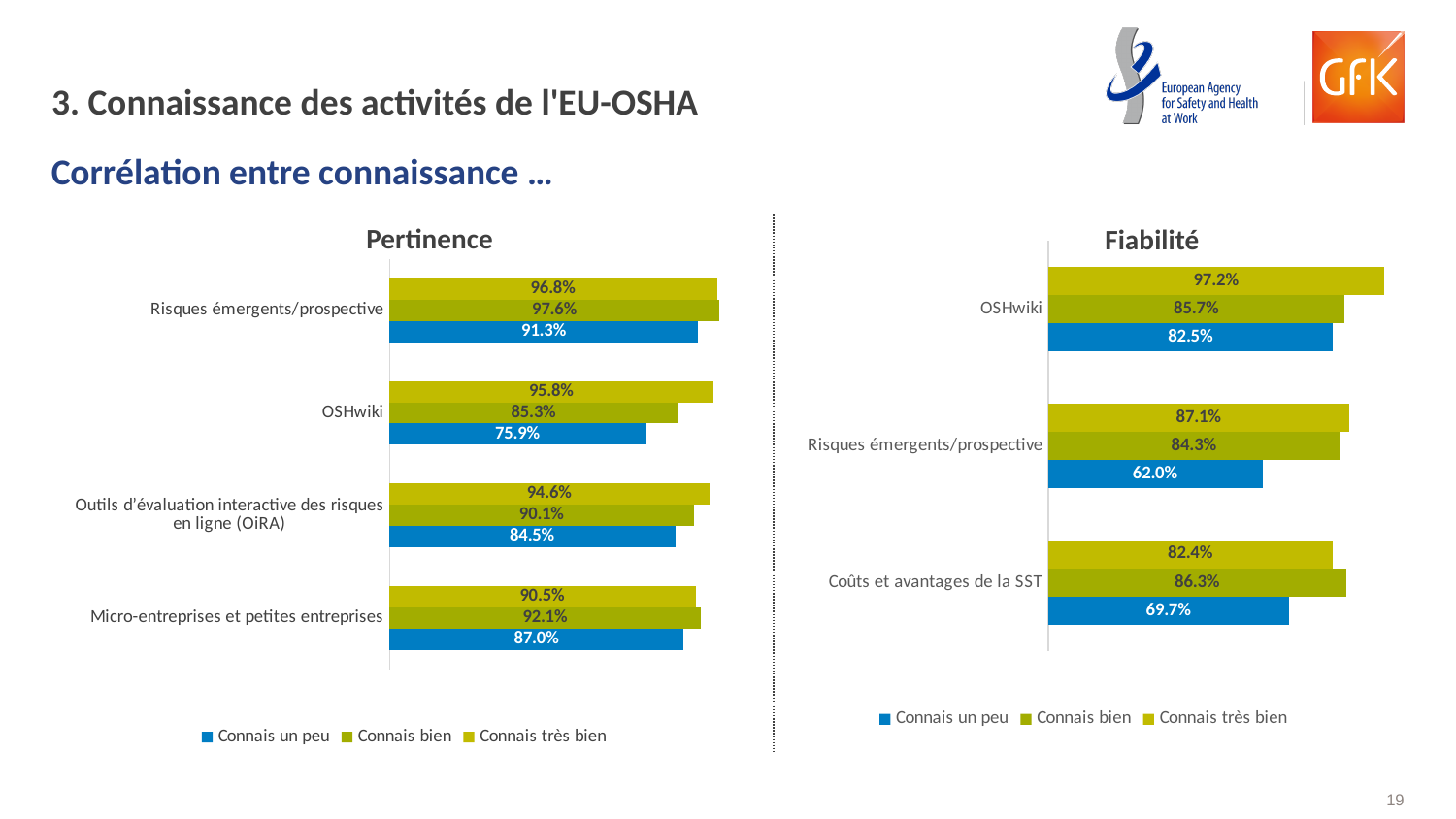
In the Pertinence chart, what is the value for 'Connais un peu' for OSHwiki? 75.9% In the Pertinence chart, which is larger for OSHwiki: 'Connais bien' or 'Connais un peu'? Connais bien In the Fiabilité chart, what is the value for 'Connais très bien' for OSHwiki? 97.2% What kind of chart is the Pertinence chart? Bar chart In the Fiabilité chart, which category has the lowest value for 'Connais un peu'? Risques émergents/prospective In the Fiabilité chart, which is larger for Coûts et avantages de la SST: 'Connais bien' or 'Connais très bien'? Connais bien In the Pertinence chart, which category has the highest value for 'Connais très bien'? Risques émergents/prospective How many categories are shown in the Fiabilité chart? 3 In the Pertinence chart, what is the value for 'Connais bien' for Micro-entreprises et petites entreprises? 92.1% In the Pertinence chart, which series is shown in blue? Connais un peu In the Fiabilité chart, what is the difference between 'Connais très bien' and 'Connais un peu' for Risques émergents/prospective? 25.1% How many series does the legend of the Pertinence chart list? 3